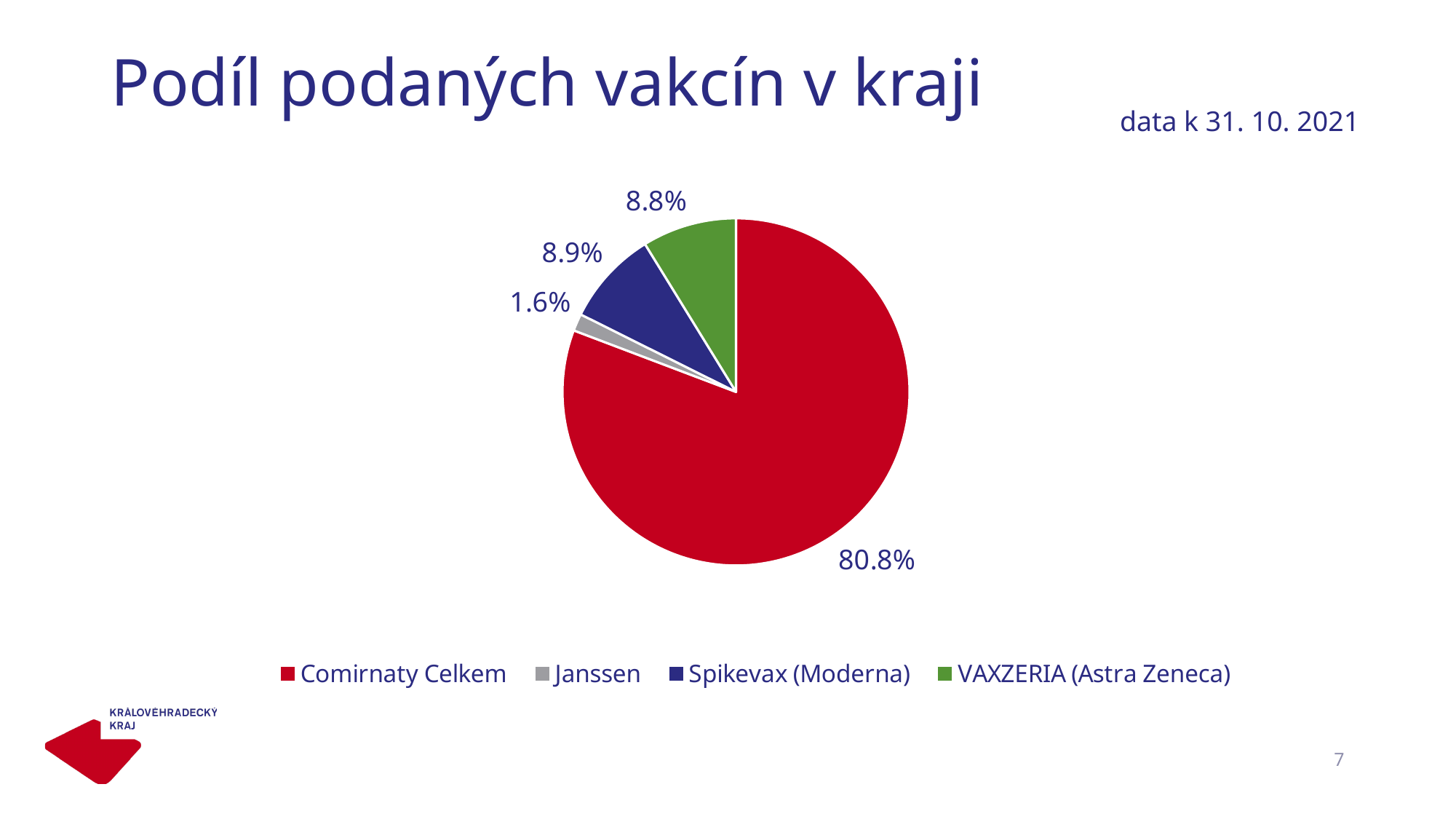
What is the title of the chart on the slide? Podíl podaných vakcín v kraji What is the difference between the shares of Comirnaty Celkem and Spikevax (Moderna)? 71.9% Which has a larger share, Janssen or VAXZERIA (Astra Zeneca)? VAXZERIA (Astra Zeneca) What is the value shown for Spikevax (Moderna)? 8.9% How many slices does the pie chart have? 4 How many entries does the legend list? 4 What kind of chart is shown on the slide? pie chart What share of the pie does Comirnaty Celkem have? 80.8% What is the value shown for Janssen? 1.6% Which vaccine has the largest share of the pie? Comirnaty Celkem What is the value shown for VAXZERIA (Astra Zeneca)? 8.8% Which vaccine has the smallest share of the pie? Janssen